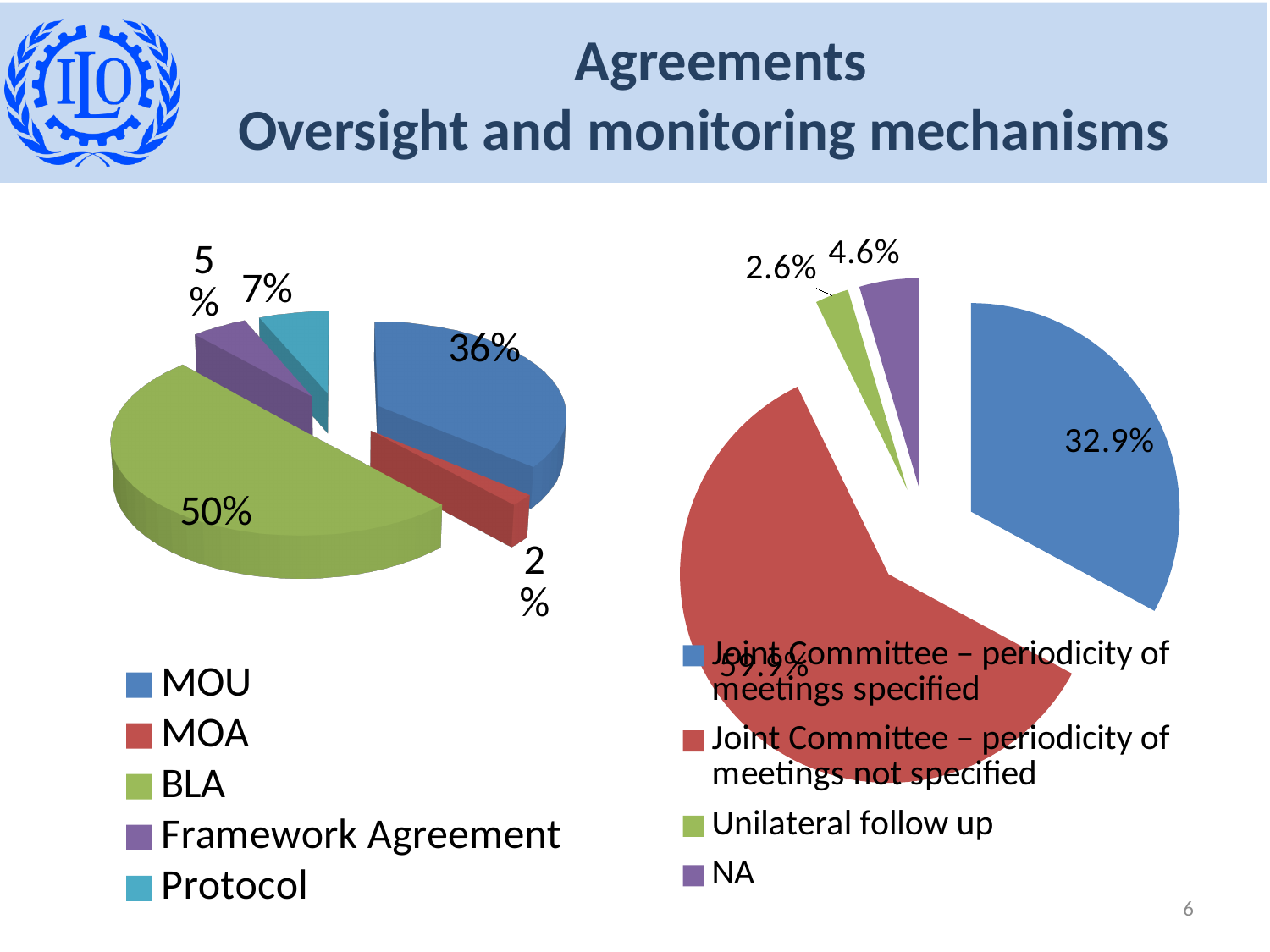
In the right pie chart, what share does 'Unilateral follow up' have? 2.6% In the right pie chart, which category has the largest share? Joint Committee – periodicity of meetings not specified In the left pie chart, what share does MOU have? 36% In the left pie chart, what share does Protocol have? 7% In the left pie chart, which category has the largest share? BLA In the left pie chart, which category has the smallest share? MOA In the left pie chart, what share does BLA have? 50% In the right pie chart, which is larger: NA or Unilateral follow up? NA How many categories does the legend of the left pie chart list? 5 In the left pie chart, what is the difference between the shares of BLA and MOU? 14% In the right pie chart, what share does 'Joint Committee – periodicity of meetings specified' have? 32.9% What type of chart is the left chart on the slide? pie chart